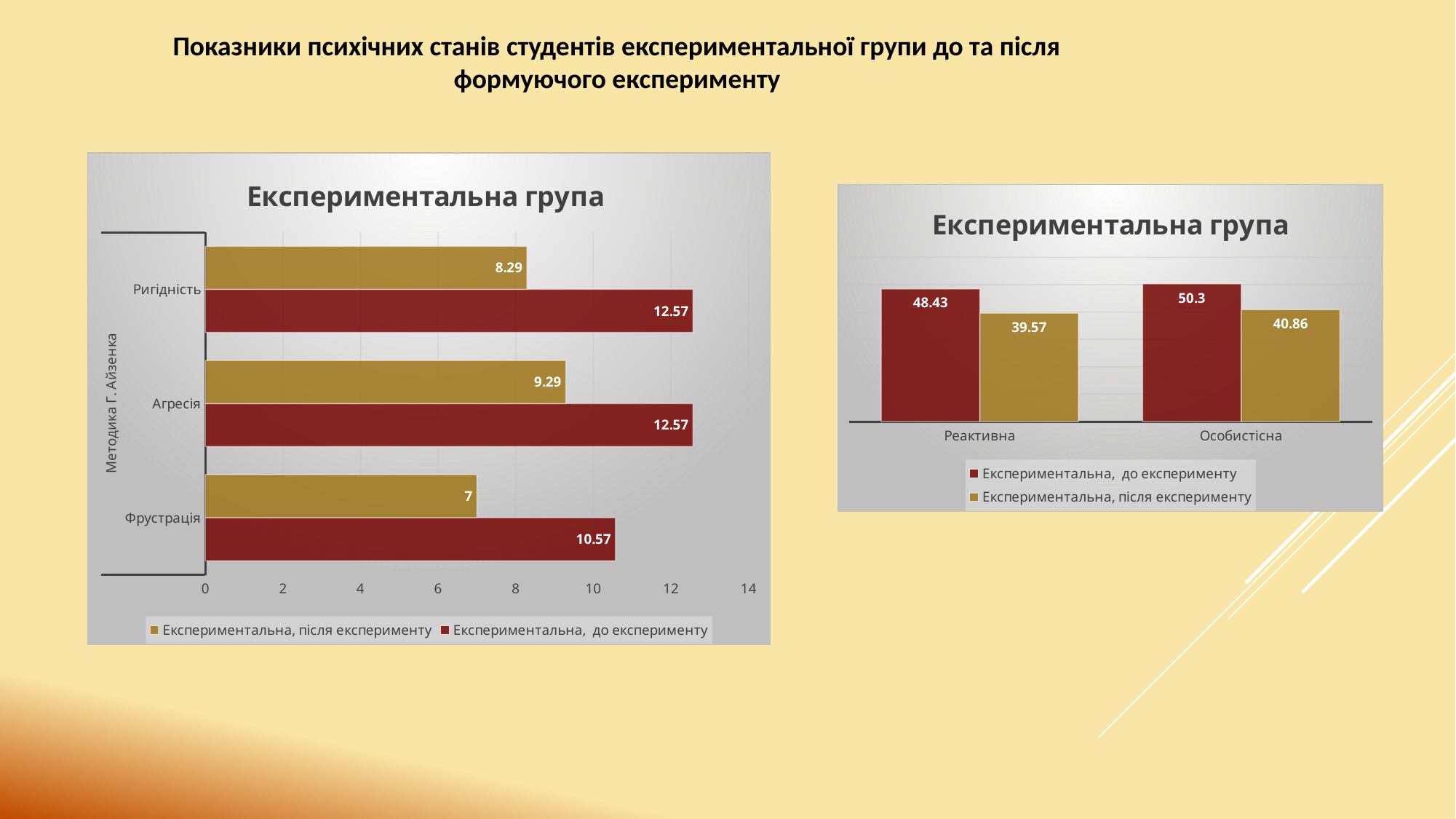
In the left chart, what is the value for Фрустрація in the series 'Експериментальна, після експерименту'? 7 In the left chart, what is the value for Агресія in the series 'Експериментальна, після експерименту'? 9.29 In the left chart, how many categories are shown on the vertical axis? 3 In the left chart, what is the difference between the 'до експерименту' and 'після експерименту' values for Ригідність? 4.28 In the right chart, what is the difference between the 'до експерименту' and 'після експерименту' values for Особистісна? 9.44 In the right chart, what is the value for Реактивна in the series 'Експериментальна, після експерименту'? 39.57 In the left chart, what is the value for Ригідність in the series 'Експериментальна, до експерименту'? 12.57 What kind of chart is the left chart? Bar chart How many series does the legend of the right chart list? 2 In the right chart, what is the value for Особистісна in the series 'Експериментальна, до експерименту'? 50.3 In the right chart, which is larger for Реактивна: the 'до експерименту' value or the 'після експерименту' value? до експерименту In the left chart, which category has the lowest value in the series 'Експериментальна, після експерименту'? Фрустрація